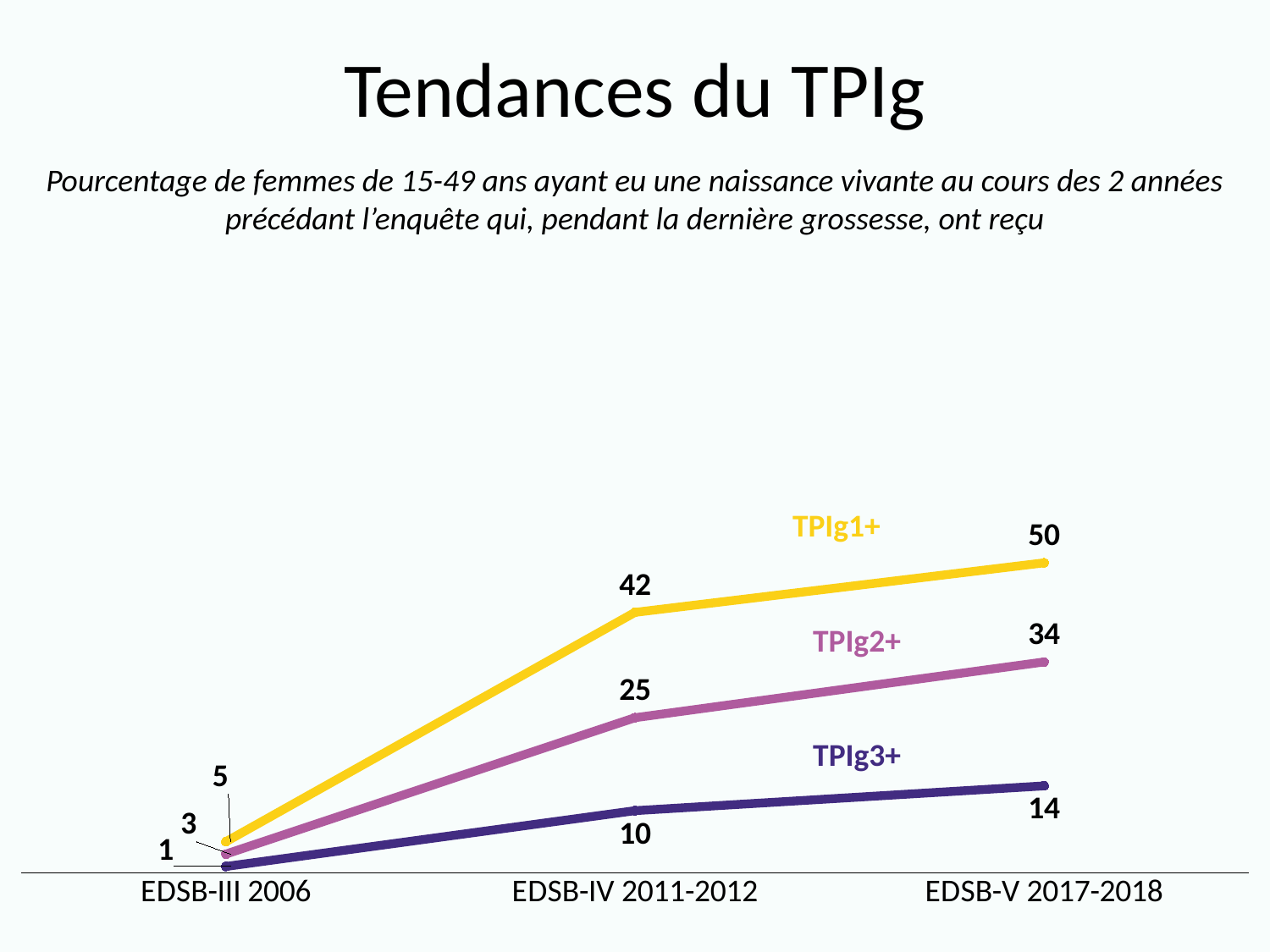
What kind of chart is shown on the slide? Line chart What is the value for TPIg3+ at EDSB-III 2006? 1 How many series are plotted on the chart? 3 Which series has the highest value at EDSB-V 2017-2018? TPIg1+ Which series has the lowest value at EDSB-IV 2011-2012? TPIg3+ What is the value for TPIg1+ at EDSB-V 2017-2018? 50 What is the difference between the TPIg3+ values at EDSB-V 2017-2018 and EDSB-IV 2011-2012? 4 What is the value for TPIg2+ at EDSB-IV 2011-2012? 25 What is the value for TPIg1+ at EDSB-III 2006? 5 Which is larger: TPIg2+ at EDSB-V 2017-2018 or TPIg1+ at EDSB-IV 2011-2012? TPIg1+ at EDSB-IV 2011-2012 How many survey points are shown on the x axis? 3 What is the difference between TPIg1+ and TPIg2+ at EDSB-V 2017-2018? 16